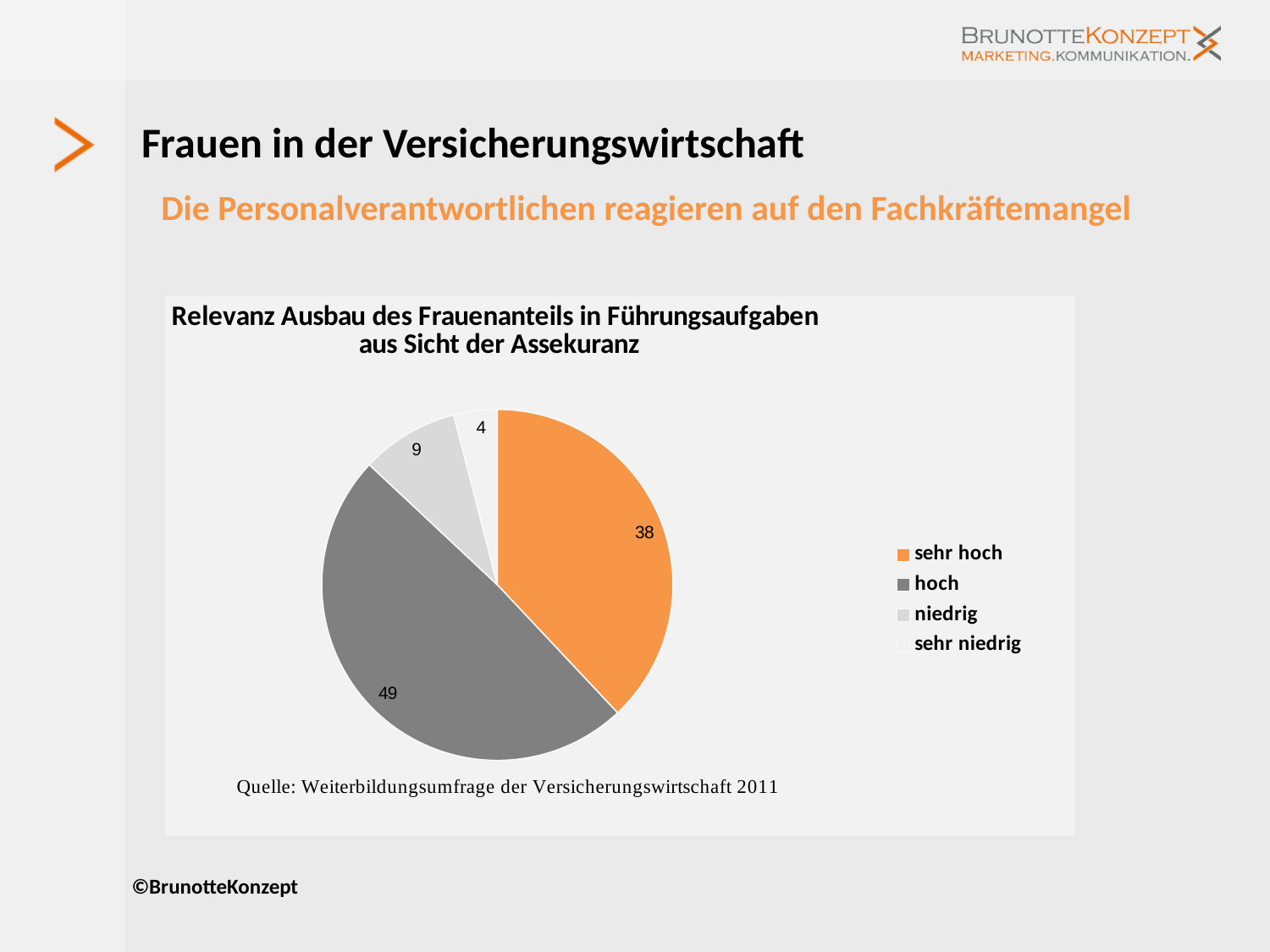
Which is larger, the value for "niedrig" or the value for "sehr niedrig"? niedrig What value is shown for the "sehr niedrig" slice of the pie chart? 4 What share of the pie does the "sehr hoch" slice represent? 38% What value is shown for the "sehr hoch" slice of the pie chart? 38 What value is shown for the "hoch" slice of the pie chart? 49 What type of chart is shown on the slide? pie chart What is the title of the chart? Relevanz Ausbau des Frauenanteils in Führungsaufgaben aus Sicht der Assekuranz Which category has the smallest slice in the pie chart? sehr niedrig Which category has the largest slice in the pie chart? hoch How many slices does the pie chart have? 4 What is the difference between the values for "hoch" and "sehr hoch"? 11 What value is shown for the "niedrig" slice of the pie chart? 9